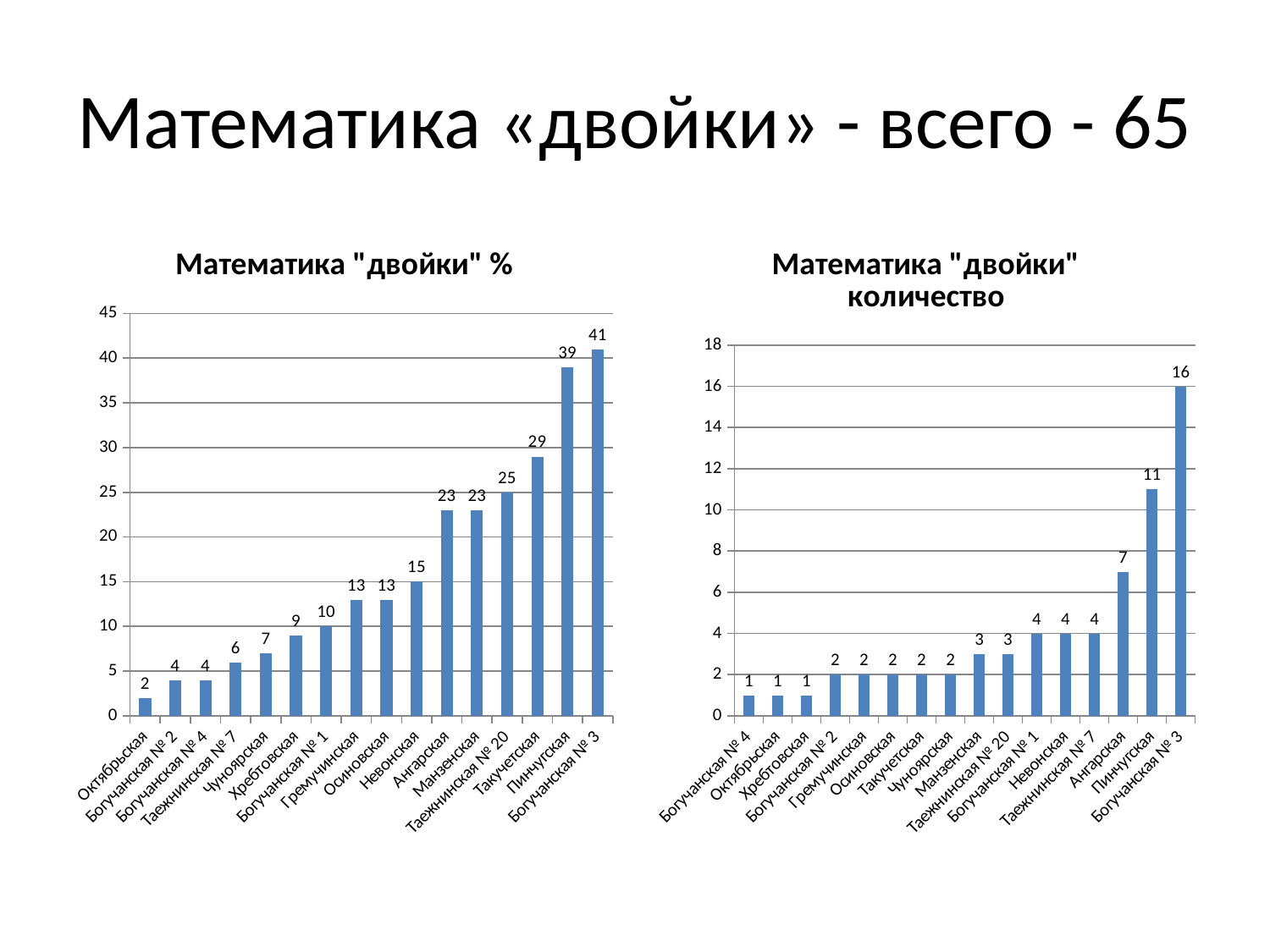
In the chart titled Математика "двойки" количество, what is the value for Богучанская № 3? 16 In the chart titled Математика "двойки" %, how many categories are shown on the x axis? 16 In the chart titled Математика "двойки" %, what is the value for Пинчугская? 39 In the chart titled Математика "двойки" количество, which category has the highest value? Богучанская № 3 In the chart titled Математика "двойки" количество, what is the difference between the values for Богучанская № 3 and Пинчугская? 5 In the chart titled Математика "двойки" количество, what is the value for Ангарская? 7 In the chart titled Математика "двойки" количество, which is larger, the value for Пинчугская or the value for Ангарская? Пинчугская In the chart titled Математика "двойки" %, which category has the lowest value? Октябрьская In the chart titled Математика "двойки" %, what is the value for Невонская? 15 What kind of chart is the chart titled Математика "двойки" количество? Bar chart In the chart titled Математика "двойки" %, which category has the highest value? Богучанская № 3 In the chart titled Математика "двойки" %, what is the difference between the values for Богучанская № 3 and Такучетская? 12